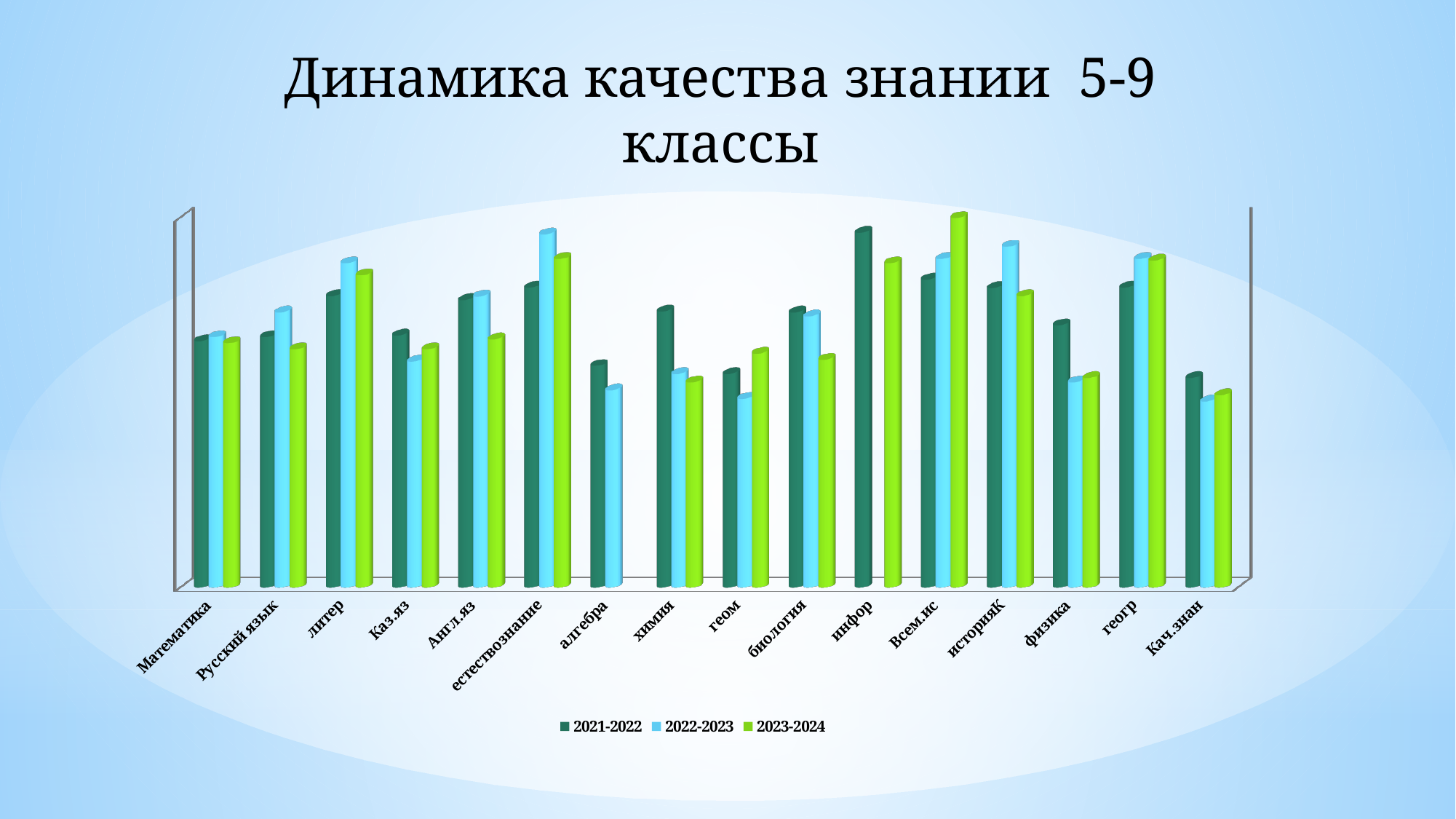
For алгебра, which is larger: the 2021-2022 bar or the 2022-2023 bar? 2021-2022 For геом, which of the three series has the tallest bar? 2023-2024 For Каз.яз, which of the three series has the tallest bar? 2021-2022 Which category has the tallest 2022-2023 bar? естествознание Which category has the tallest 2021-2022 bar? инфор Which category has the tallest 2023-2024 bar? Всем.ис How many subject categories are shown along the x axis? 16 How many series does the legend list? 3 What kind of chart is shown on the slide? bar chart What is the title of the chart? Динамика качества знании 5-9 классы Which series are listed in the legend? 2021-2022, 2022-2023, 2023-2024